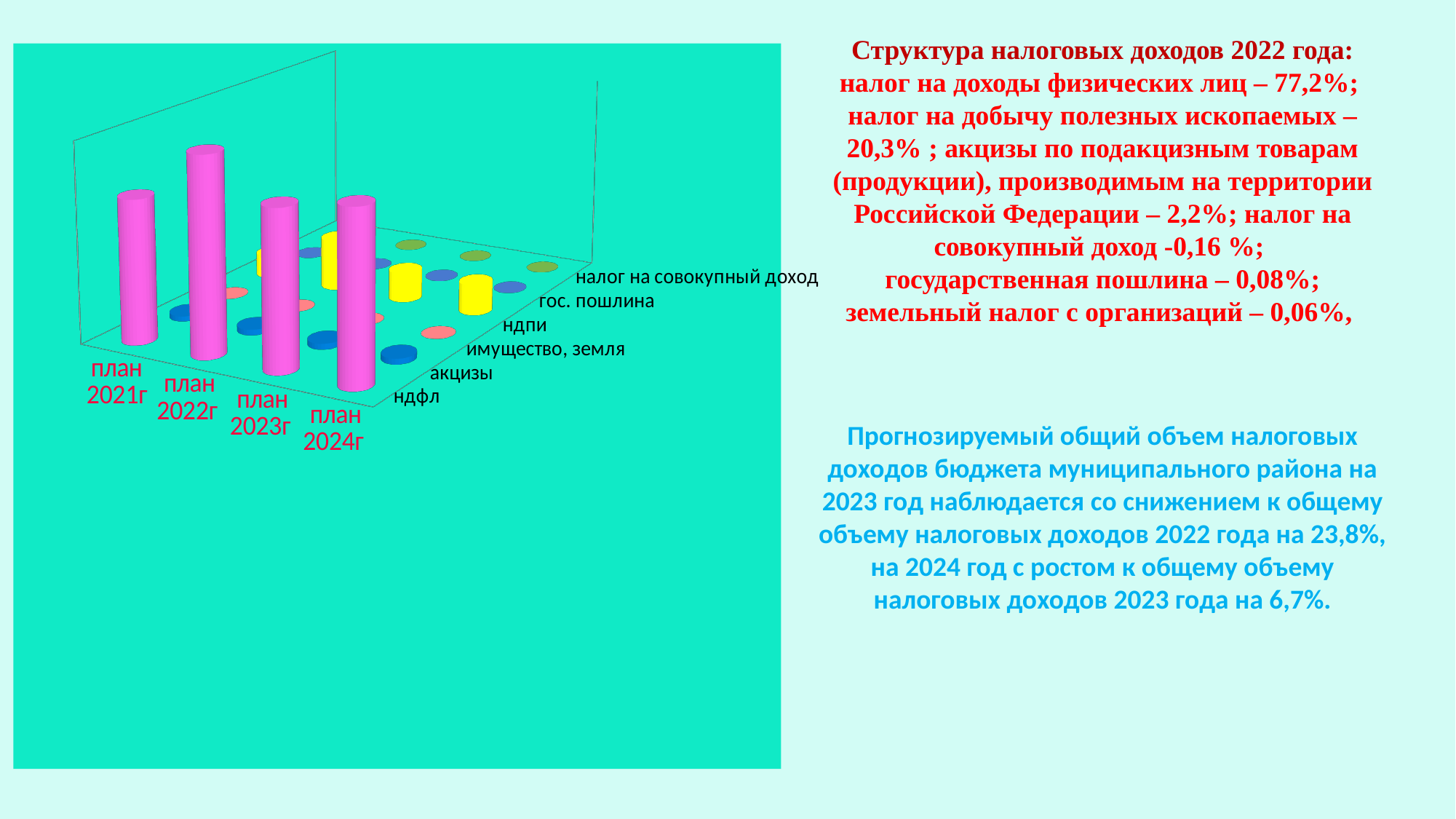
Which tax type has the second tallest bars in the chart? ндпи For which plan year is the ндфл bar the tallest? план 2022г What is the label of the last category on the front axis of the chart? план 2024г What colour are the ндпи bars in the chart? yellow How many plan years (categories) are shown along the front axis of the chart? 4 Which is larger for ндфл: план 2021г or план 2022г? план 2022г What colour are the ндфл bars in the chart? pink How many tax types (series) are labelled along the depth axis of the chart? 6 Which is larger for план 2024г: ндфл or ндпи? ндфл Does the ндфл value rise or fall from план 2021г to план 2022г? rise What kind of chart is shown on the slide? bar chart Which tax type has the tallest bars in the chart? ндфл